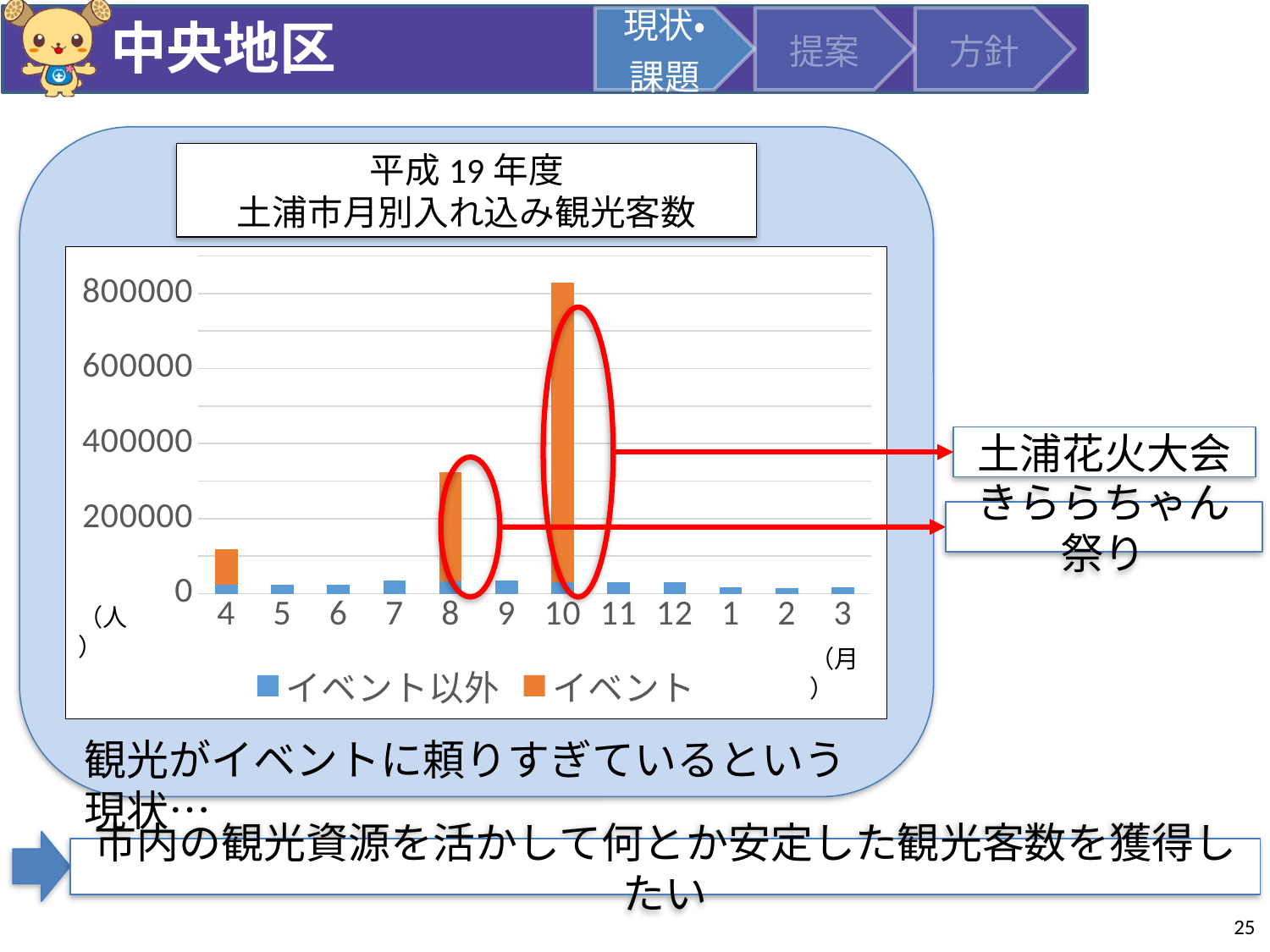
How many months are shown along the x axis of the chart? 12 Is the イベント value for month 10 greater or less than 600000? greater Which series is shown in orange in the chart? イベント Which month is the first category on the x axis of the chart? 4 Is the イベント value for month 8 greater or less than 200000? greater Is the イベント value for month 8 greater or less than 400000? less Which month has the highest value for the イベント series? 10 What kind of chart is shown on the slide? bar chart What is the title of the chart? 平成19年度 土浦市月別入れ込み観光客数 Which is larger, the イベント value for month 10 or the イベント value for month 8? month 10 How many series does the chart legend list? 2